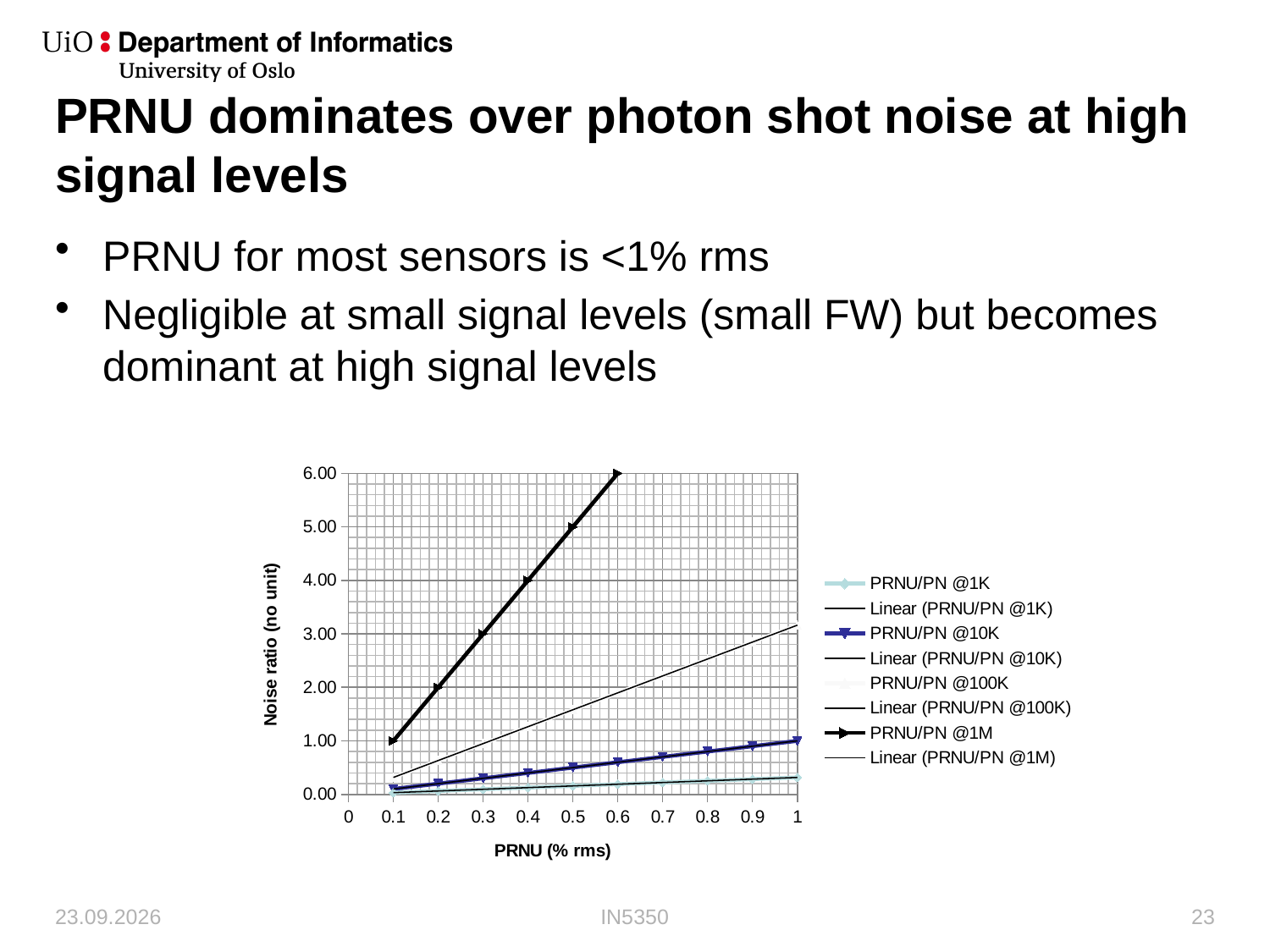
What is the value of PRNU/PN @1M at PRNU 0.1 % rms? 1.00 Does the PRNU/PN @1M series rise or fall as PRNU (% rms) increases? rise Is the value of PRNU/PN @10K at PRNU 0.5 % rms greater or less than 1.00? less What is the label of the chart's y axis? Noise ratio (no unit) What is the value of PRNU/PN @1M at PRNU 0.4 % rms? 4.00 What kind of chart is shown on the slide? line chart What is the value of PRNU/PN @1M at PRNU 0.6 % rms? 6.00 At PRNU 0.5 % rms, which series has the larger value, PRNU/PN @1M or PRNU/PN @10K? PRNU/PN @1M How many series does the chart legend list? 8 What is the label of the chart's x axis? PRNU (% rms) What is the difference between PRNU/PN @1M at 0.5 % rms and at 0.2 % rms? 3.00 What is the value of PRNU/PN @10K at PRNU 1 % rms? 1.00